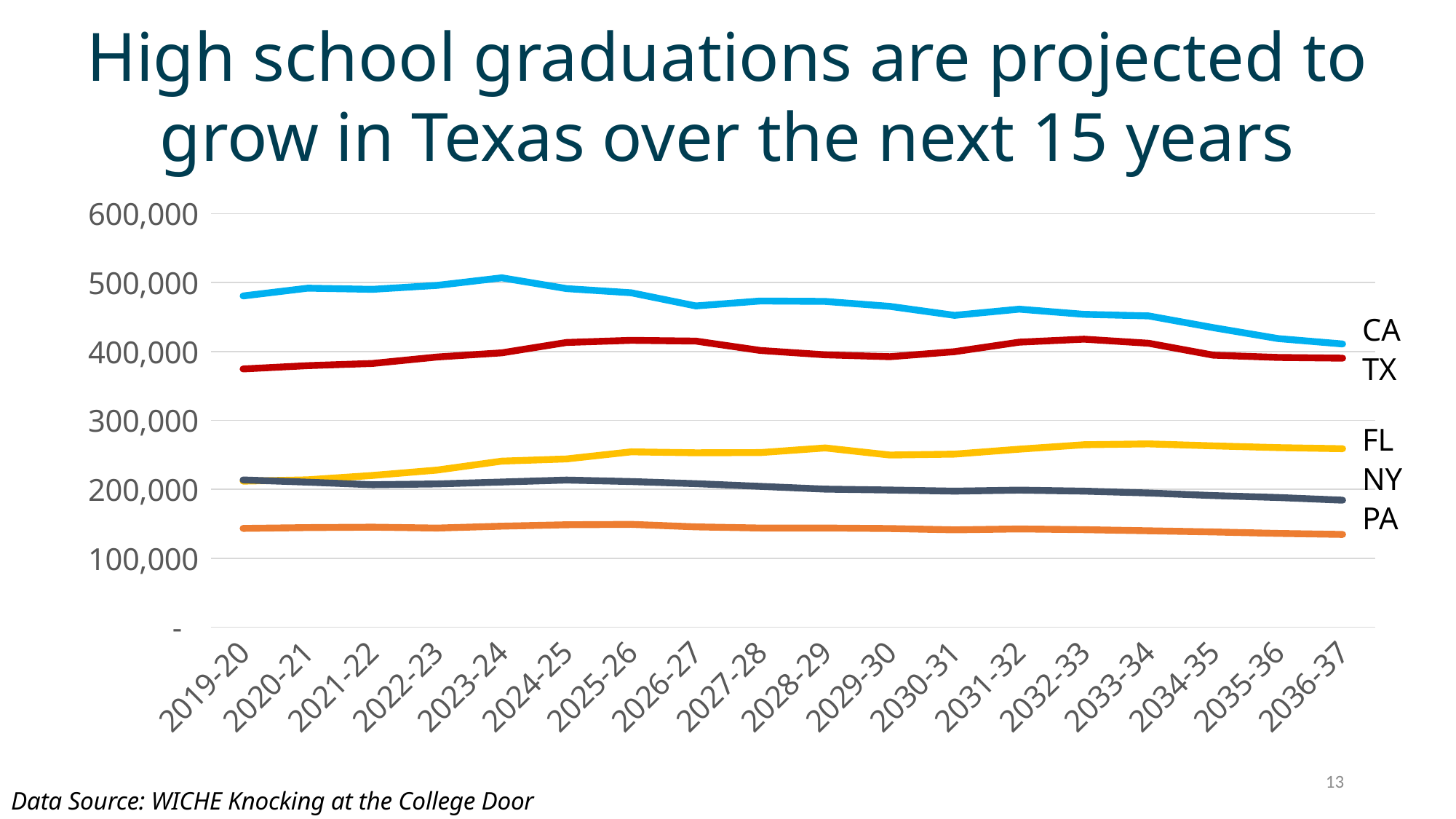
Which state has the highest projected number of high school graduations across the chart? CA Is the value for FL in 2036-37 greater or less than 200,000? greater What data source is cited at the bottom of the slide? WICHE Knocking at the College Door How many series (states) are plotted on the chart? 5 Is the value for CA in 2019-20 greater or less than 400,000? greater Does the CA line rise or fall from 2019-20 to 2036-37? fall What kind of chart is shown on the slide? line chart How many school years are shown along the x axis? 18 Which state has the lowest projected number of high school graduations across the chart? PA Which is larger in 2019-20, the value for CA or the value for TX? CA Is the value for PA in 2036-37 greater or less than 200,000? less